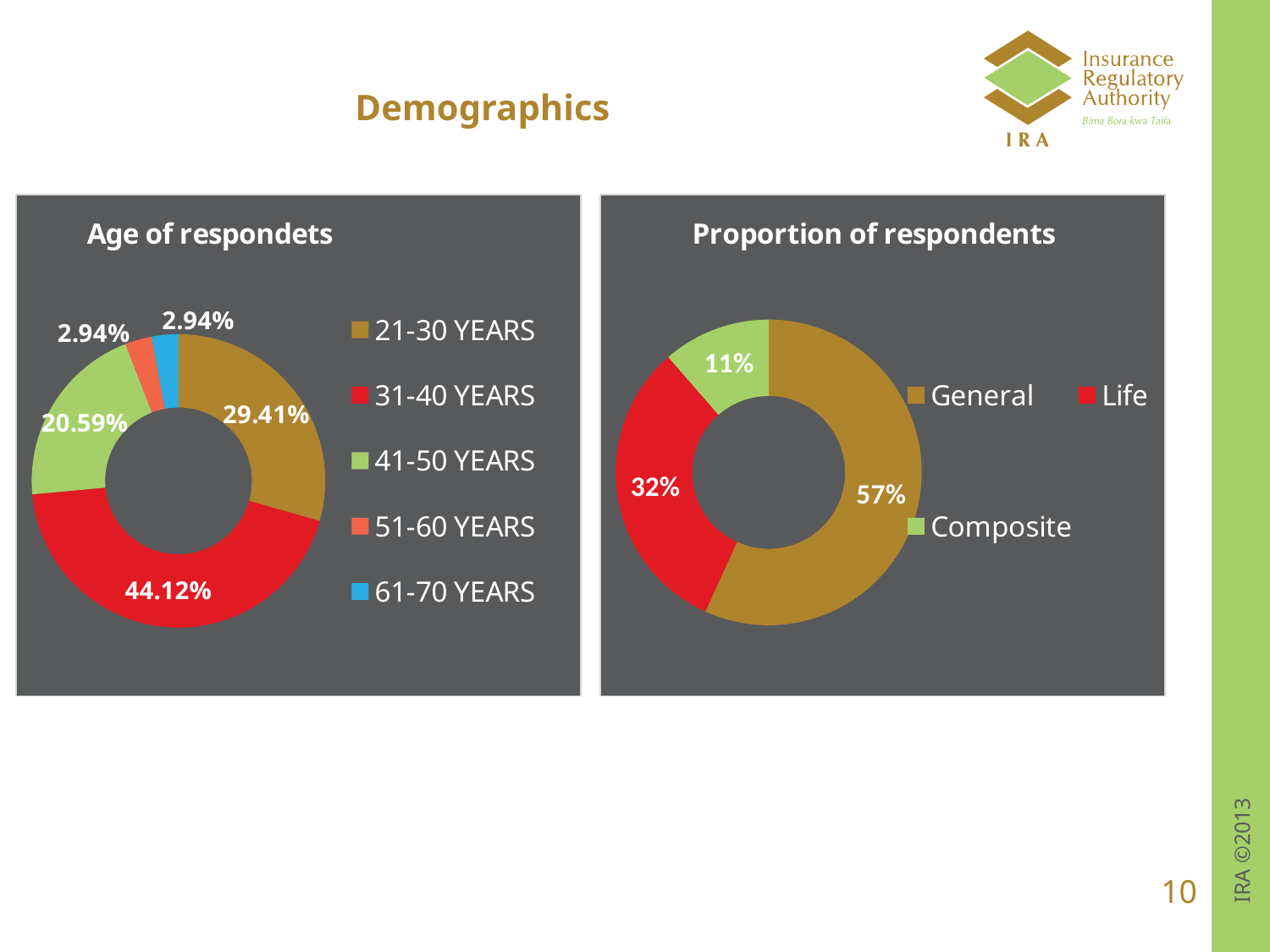
In the 'Proportion of respondents' chart, which category has the smallest share? Composite In the 'Age of respondets' chart, what percentage of respondents are aged 51-60 years? 2.94% In the 'Age of respondets' chart, what is the difference between the 31-40 years share and the 41-50 years share? 23.53% In the 'Age of respondets' chart, what percentage of respondents are aged 31-40 years? 44.12% How many categories does the legend of the 'Proportion of respondents' chart list? 3 In the 'Proportion of respondents' chart, what is the difference between the General share and the Life share? 25% What type of chart is the 'Proportion of respondents' chart? Doughnut chart How many age groups are shown in the 'Age of respondets' chart? 5 In the 'Age of respondets' chart, which is larger: the share for 21-30 years or the share for 41-50 years? 21-30 YEARS In the 'Age of respondets' chart, which age group has the largest share? 31-40 YEARS In the 'Age of respondets' chart, what percentage of respondents are aged 21-30 years? 29.41% In the 'Proportion of respondents' chart, what share is labelled General? 57%